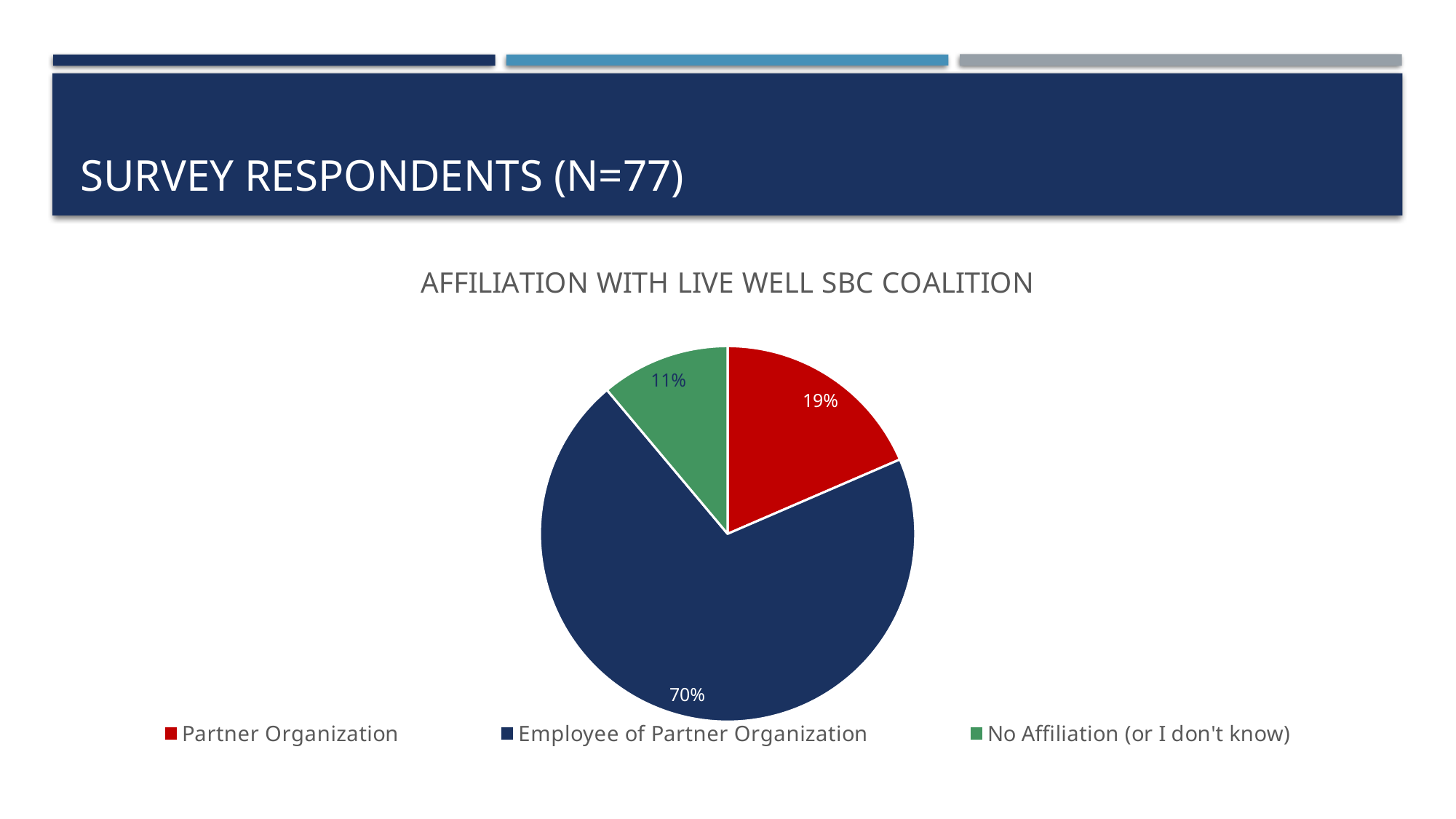
What is the difference in percentage points between Employee of Partner Organization and Partner Organization? 51 What share of respondents are an Employee of Partner Organization? 70% Which is larger: the share for Partner Organization or the share for No Affiliation (or I don't know)? Partner Organization What is the title of the chart? AFFILIATION WITH LIVE WELL SBC COALITION Which affiliation category has the smallest share of respondents? No Affiliation (or I don't know) What colour is the slice for Employee of Partner Organization? Dark blue What is the difference in percentage points between Partner Organization and No Affiliation (or I don't know)? 8 What share of respondents are from a Partner Organization? 19% What kind of chart is shown on the slide? Pie chart What share of respondents have No Affiliation (or I don't know)? 11% How many categories does the pie chart show? 3 Which affiliation category has the largest share of respondents? Employee of Partner Organization